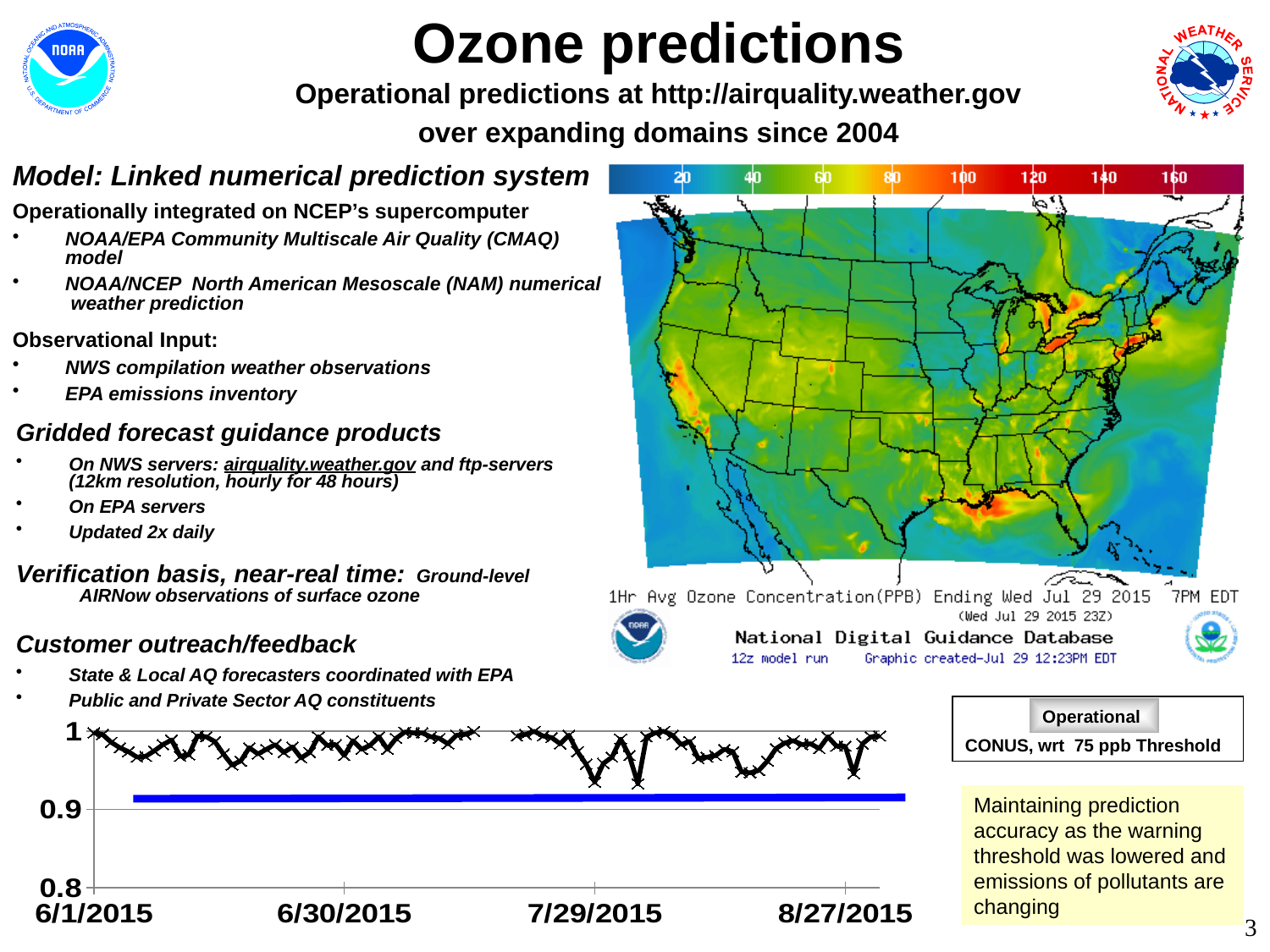
In the bottom line chart, what is the lowest value labelled on the y axis? 0.8 In the bottom line chart, does the lowest dip of the black line occur before or after 6/30/2015? after In the bottom line chart, what is the first date shown on the x axis? 6/1/2015 In the bottom line chart, what is the highest value labelled on the y axis? 1 What kind of chart is shown at the bottom of the slide with the dates on the x axis? line chart In the bottom line chart, what is the last date shown on the x axis? 8/27/2015 In the bottom line chart, is the black line with x markers greater or less than 0.9 throughout the period? greater In the bottom line chart, what colour is the flat horizontal line? blue In the bottom line chart, how many date labels are shown on the x axis? 4 On the ozone concentration map, what is the highest value labelled on the colour scale? 160 In the bottom line chart, does the flat blue line rise, fall, or stay level across the x axis? stay level In the bottom line chart, is the flat blue line greater or less than 1? less